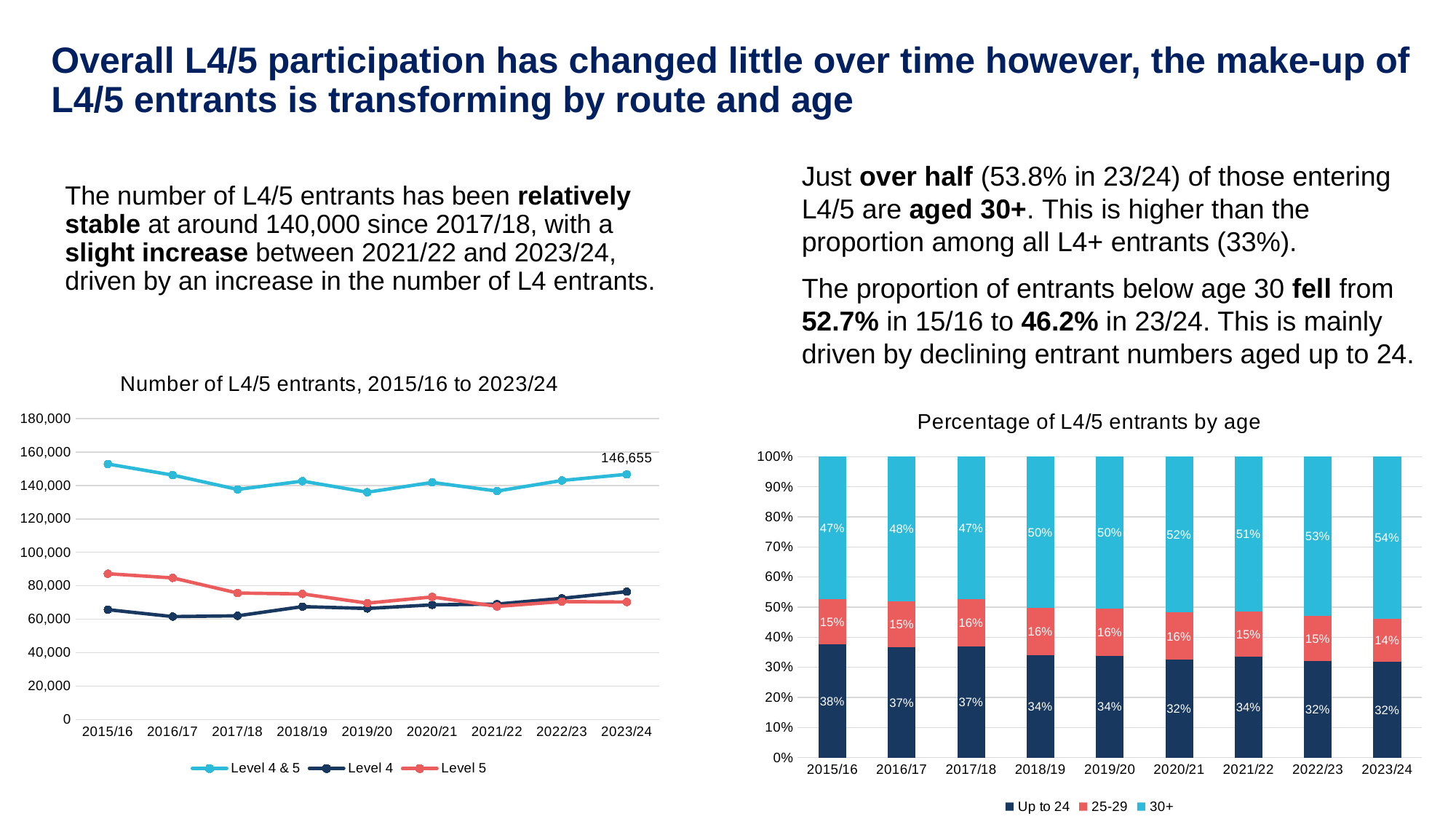
How many series does the legend of the chart 'Number of L4/5 entrants, 2015/16 to 2023/24' list? 3 What kind of chart is 'Number of L4/5 entrants, 2015/16 to 2023/24'? Line chart In the chart 'Number of L4/5 entrants, 2015/16 to 2023/24', what is the value for Level 4 & 5 in 2023/24? 146,655 In the chart 'Percentage of L4/5 entrants by age', by how many percentage points did the share of entrants aged up to 24 fall between 2015/16 and 2023/24? 6 percentage points In the chart 'Percentage of L4/5 entrants by age', which year has the highest share of entrants aged 30+? 2023/24 What kind of chart is 'Percentage of L4/5 entrants by age'? Stacked bar chart In the chart 'Percentage of L4/5 entrants by age', which year has the lowest share of entrants aged 25-29? 2023/24 In the chart 'Number of L4/5 entrants, 2015/16 to 2023/24', does the Level 5 series generally rise or fall from 2015/16 to 2023/24? Fall In the chart 'Percentage of L4/5 entrants by age', what is the share of entrants aged 30+ in 2023/24? 54% In the chart 'Number of L4/5 entrants, 2015/16 to 2023/24', is the value for Level 5 in 2015/16 greater or less than 80,000? greater In the chart 'Number of L4/5 entrants, 2015/16 to 2023/24', which is larger in 2015/16: Level 4 or Level 5? Level 5 In the chart 'Percentage of L4/5 entrants by age', what is the share of entrants aged up to 24 in 2015/16? 38%